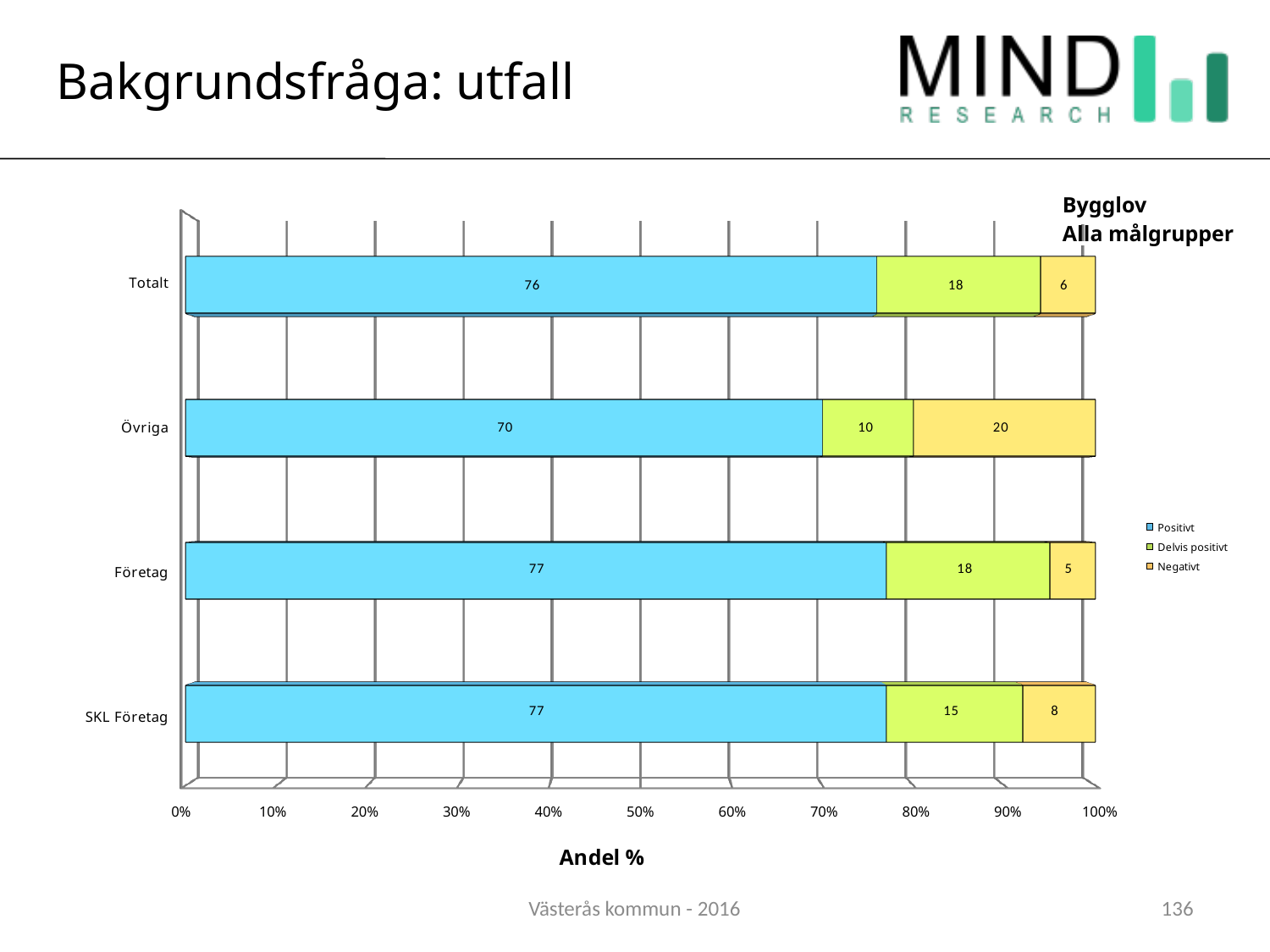
What is the difference between the Negativt values for Övriga and Företag? 15 How many series does the legend list? 3 What is the x axis title of the chart? Andel % What is the Delvis positivt value for Totalt? 18 What is the total of the stacked bar for Totalt? 100 Which category has the lowest Positivt value? Övriga Which is larger, the Delvis positivt value for Företag or for SKL Företag? Företag Which category has the highest Negativt value? Övriga What kind of chart is shown? Stacked bar chart What is the Negativt value for SKL Företag? 8 How many categories are shown on the y axis? 4 What is the Positivt value for Övriga? 70